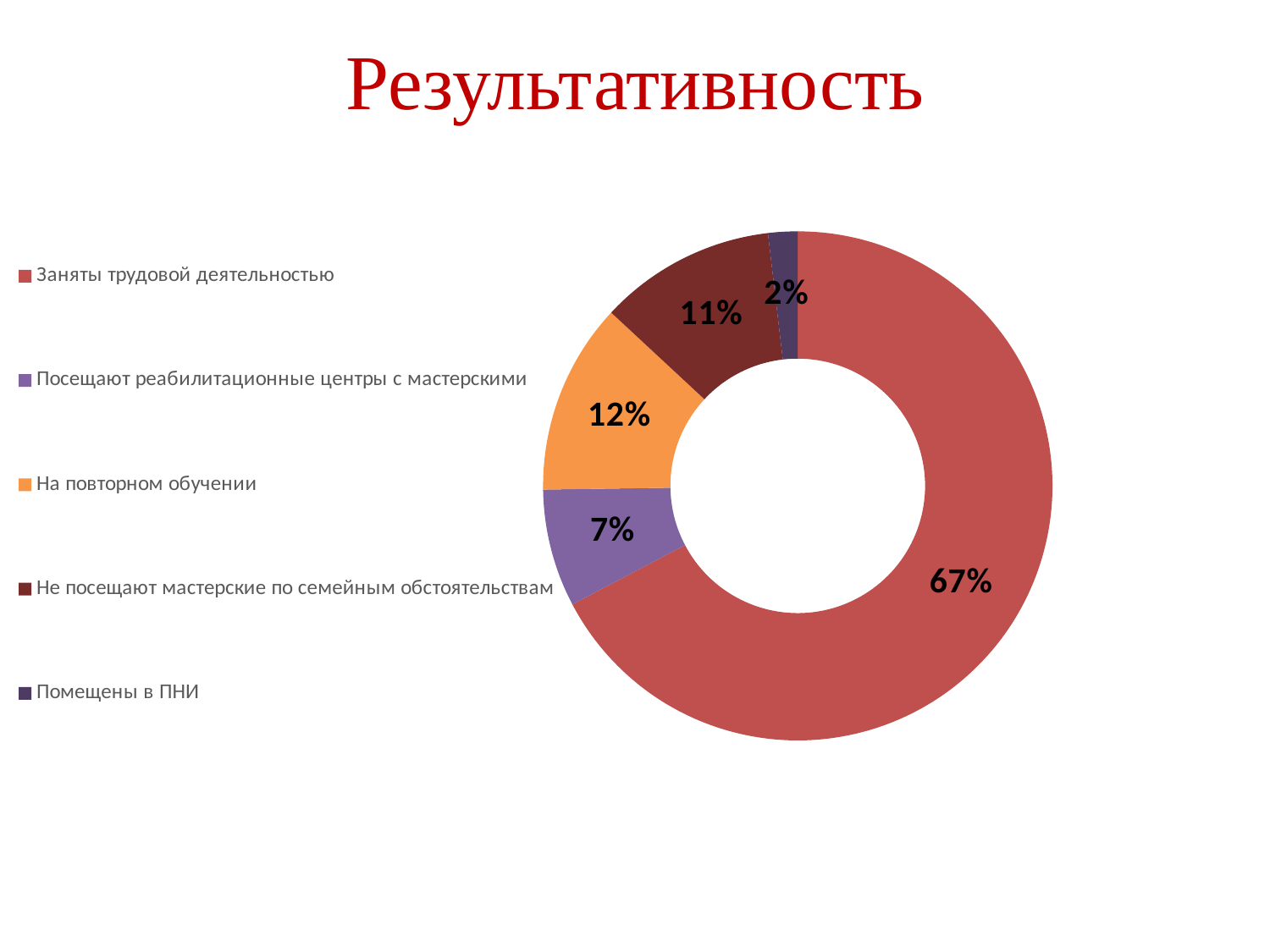
Which category has the smallest share? Помещены в ПНИ What kind of chart is shown on the slide? Doughnut (pie) chart What is the title of the slide? Результативность How many categories are shown in the chart? 5 What is the value for 'Посещают реабилитационные центры с мастерскими'? 7% What is the difference between the shares for 'На повторном обучении' and 'Посещают реабилитационные центры с мастерскими'? 5% Which is larger: 'На повторном обучении' or 'Не посещают мастерские по семейным обстоятельствам'? На повторном обучении What is the value for 'На повторном обучении'? 12% Which category has the largest share? Заняты трудовой деятельностью What is the value for 'Помещены в ПНИ'? 2% What is the value for 'Не посещают мастерские по семейным обстоятельствам'? 11% What share of the chart does 'Заняты трудовой деятельностью' represent? 67%